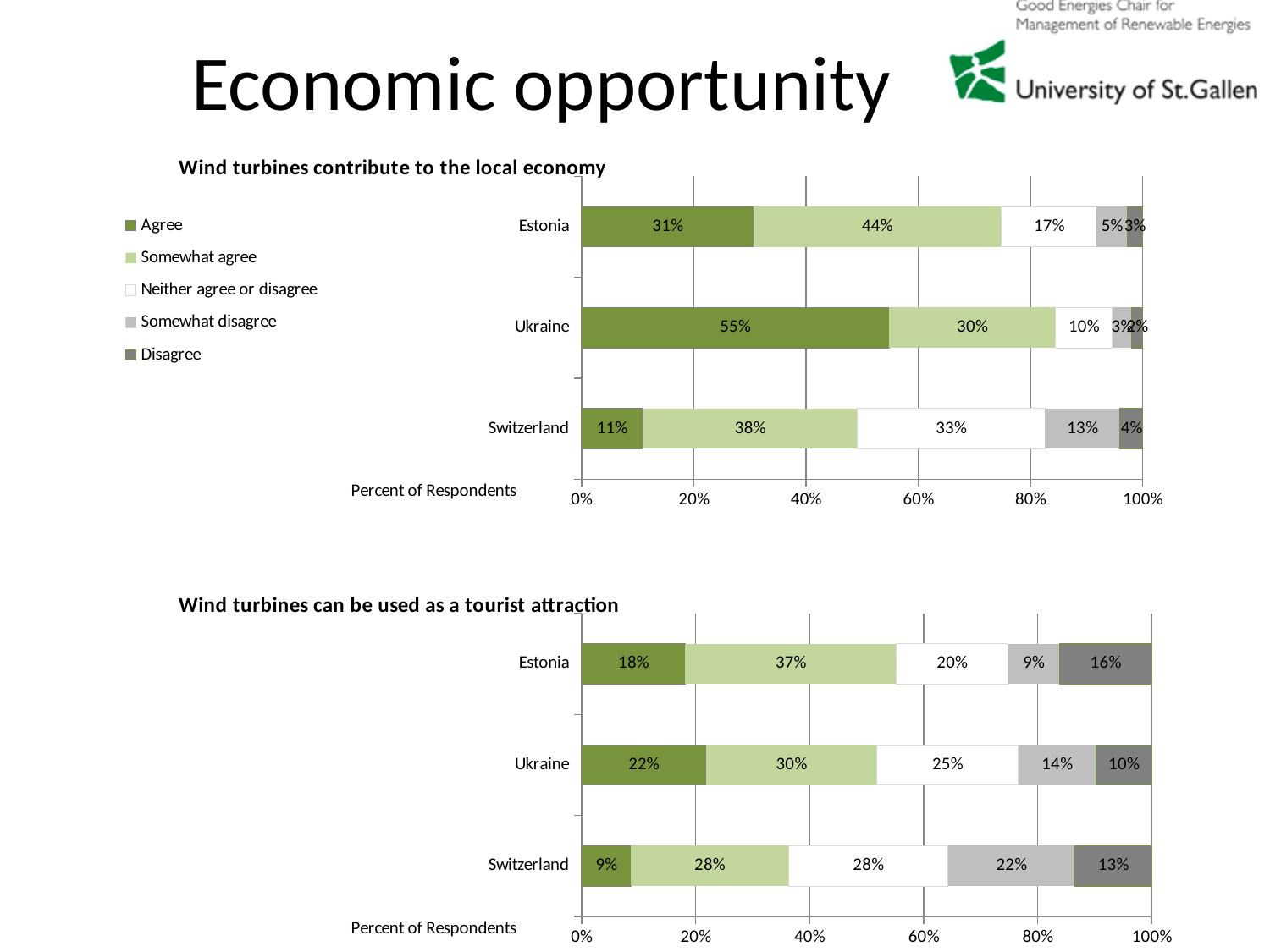
In the chart titled 'Wind turbines can be used as a tourist attraction', what is the difference between the 'Neither agree or disagree' values for Switzerland and Estonia? 8% In the chart titled 'Wind turbines can be used as a tourist attraction', what is the 'Somewhat disagree' value for Switzerland? 22% In the chart titled 'Wind turbines can be used as a tourist attraction', what is the 'Disagree' value for Estonia? 16% In the chart titled 'Wind turbines can be used as a tourist attraction', which country has the highest 'Somewhat agree' share? Estonia In the chart titled 'Wind turbines contribute to the local economy', what is the difference between the 'Somewhat agree' values for Estonia and Ukraine? 14% In the chart titled 'Wind turbines contribute to the local economy', what percentage of Ukraine respondents chose 'Agree'? 55% In the chart titled 'Wind turbines contribute to the local economy', which country has the lowest 'Agree' share? Switzerland In the chart titled 'Wind turbines can be used as a tourist attraction', is the 'Agree' value larger for Ukraine or for Switzerland? Ukraine What kind of chart is the chart titled 'Wind turbines can be used as a tourist attraction'? Stacked bar chart How many series does the legend on the slide list? 5 In the chart titled 'Wind turbines contribute to the local economy', which country has the highest 'Agree' share? Ukraine In the chart titled 'Wind turbines contribute to the local economy', what is the 'Neither agree or disagree' value for Switzerland? 33%